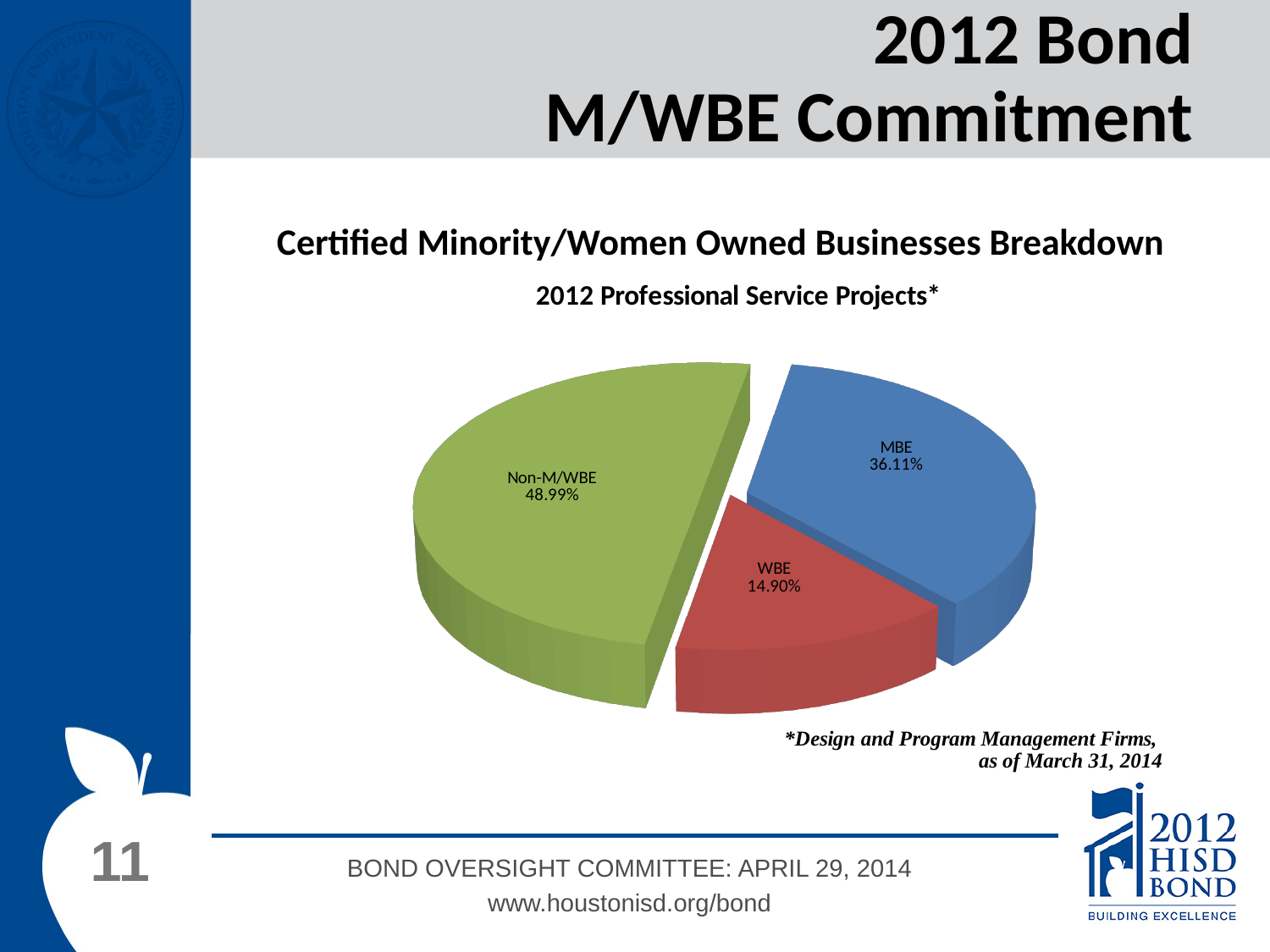
What percentage of the pie is Non-M/WBE? 48.99% What is the difference in percentage points between the Non-M/WBE slice and the MBE slice? 12.88 What percentage of the pie is MBE? 36.11% Which is larger, the MBE slice or the WBE slice? MBE What type of chart is shown on the slide? pie chart Which slice of the pie is the smallest? WBE Which slice of the pie is the largest? Non-M/WBE What percentage of the pie is WBE? 14.90% What is the difference in percentage points between the MBE slice and the WBE slice? 21.21 What is the subtitle of the chart, shown below the main chart title? 2012 Professional Service Projects* How many slices does the pie chart have? 3 What colour is the Non-M/WBE slice? green